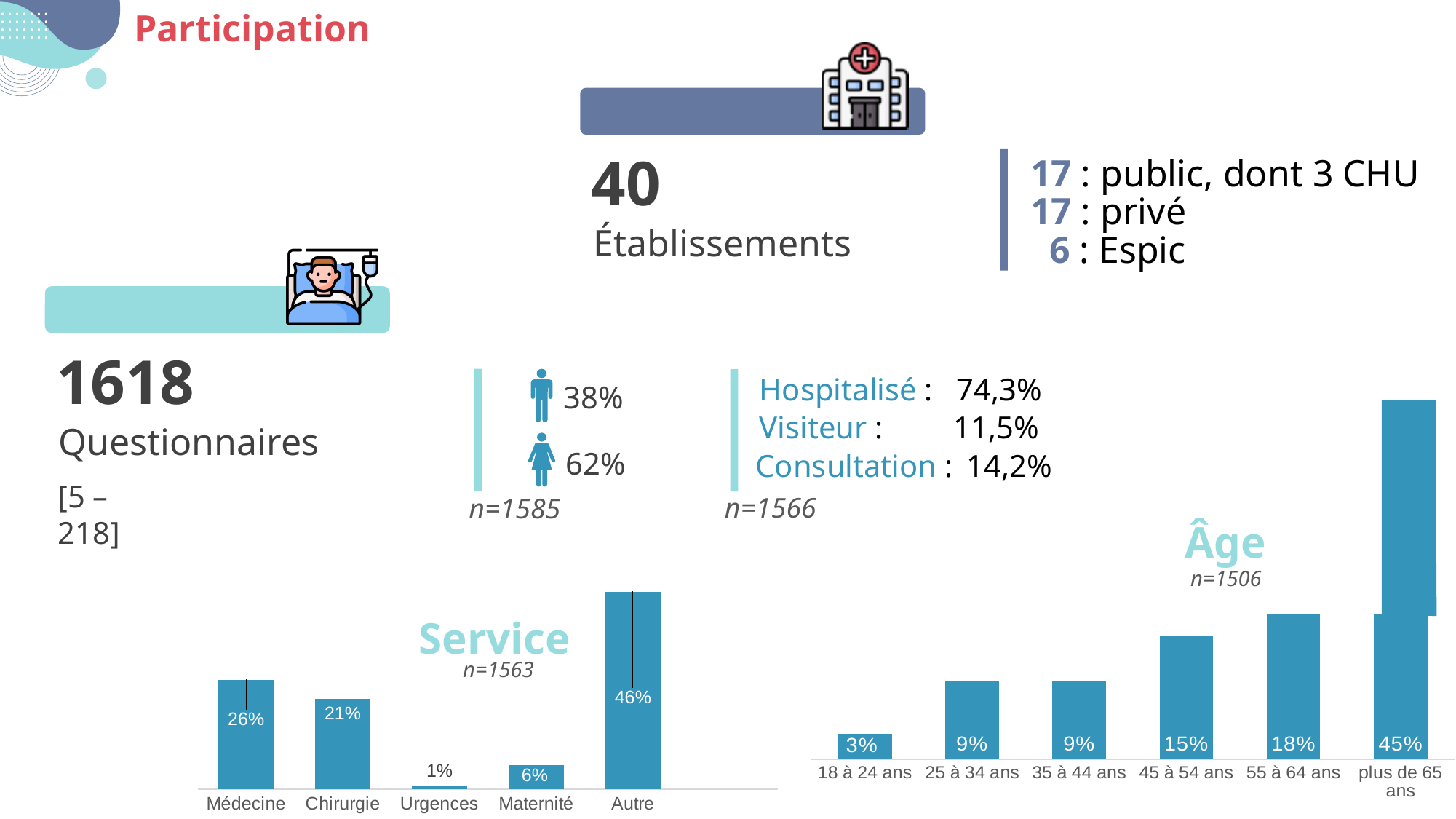
In the Âge chart, which is larger: 55 à 64 ans or 25 à 34 ans? 55 à 64 ans In the Âge chart, do the values generally rise or fall from the youngest to the oldest age group? rise In the Âge chart, which age group has the lowest value? 18 à 24 ans In the Service chart, how many categories are shown? 5 What kind of chart is the Service chart? bar chart In the Service chart, what is the difference between Autre and Chirurgie? 25% In the Âge chart, which age group has the highest value? plus de 65 ans In the Service chart, what is the value for Médecine? 26% In the Âge chart, what is the value for 45 à 54 ans? 15% In the Âge chart, what is the difference between plus de 65 ans and 55 à 64 ans? 27% In the Service chart, which category has the lowest value? Urgences In the Service chart, which category has the highest value? Autre